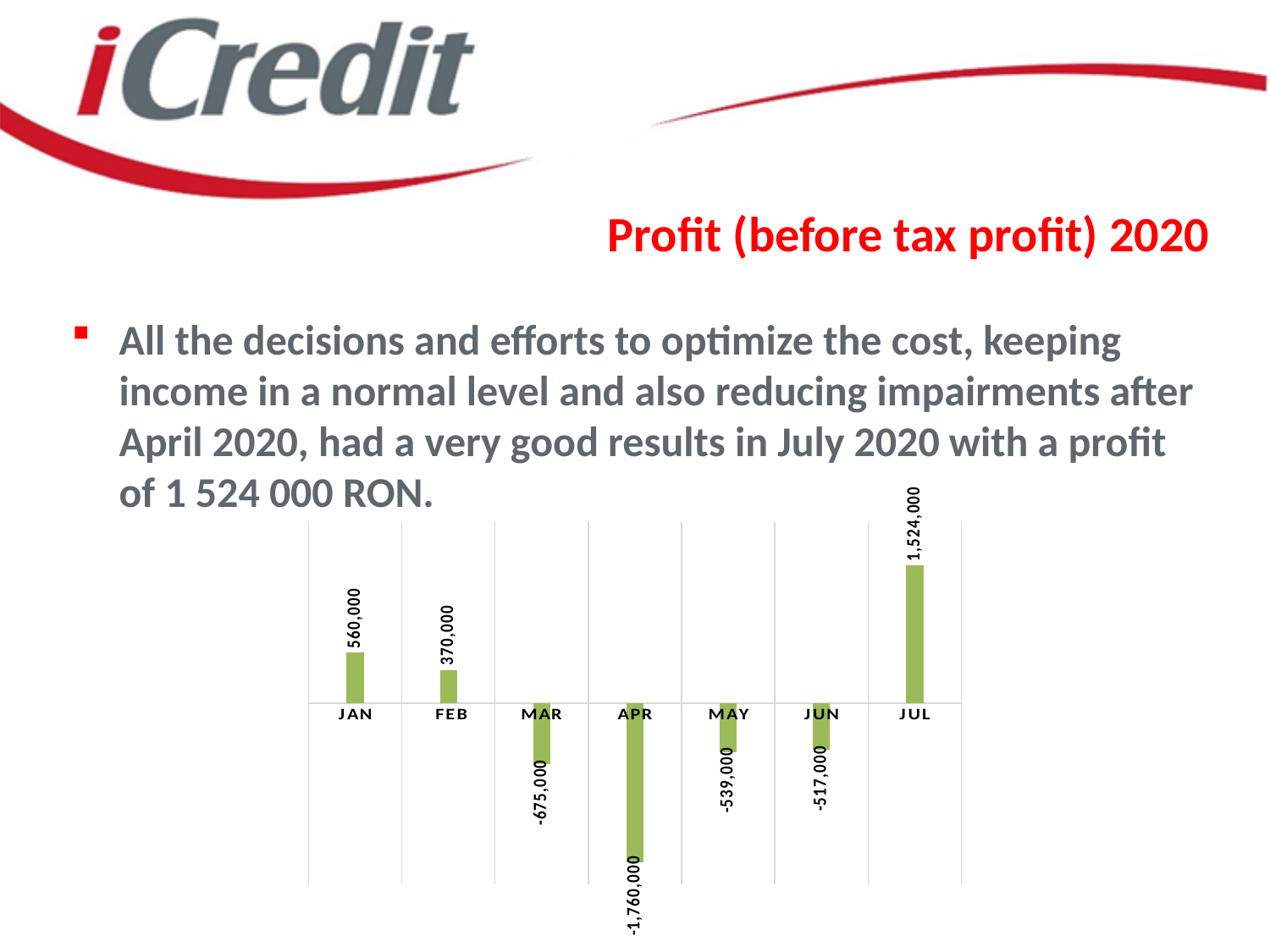
What is the value for APR? -1,760,000 Which month has the lowest value? APR What is the value for JUN? -517,000 How many months are shown on the chart? 7 What is the difference between the values for JAN and FEB? 190,000 Which is larger, the value for MAY or the value for JUN? JUN Which month has the highest value? JUL What is the value for JAN? 560,000 What kind of chart is shown on the slide? bar chart Which is larger, the value for MAR or the value for MAY? MAY How many months have negative values? 4 What is the difference between the values for JUL and JAN? 964,000